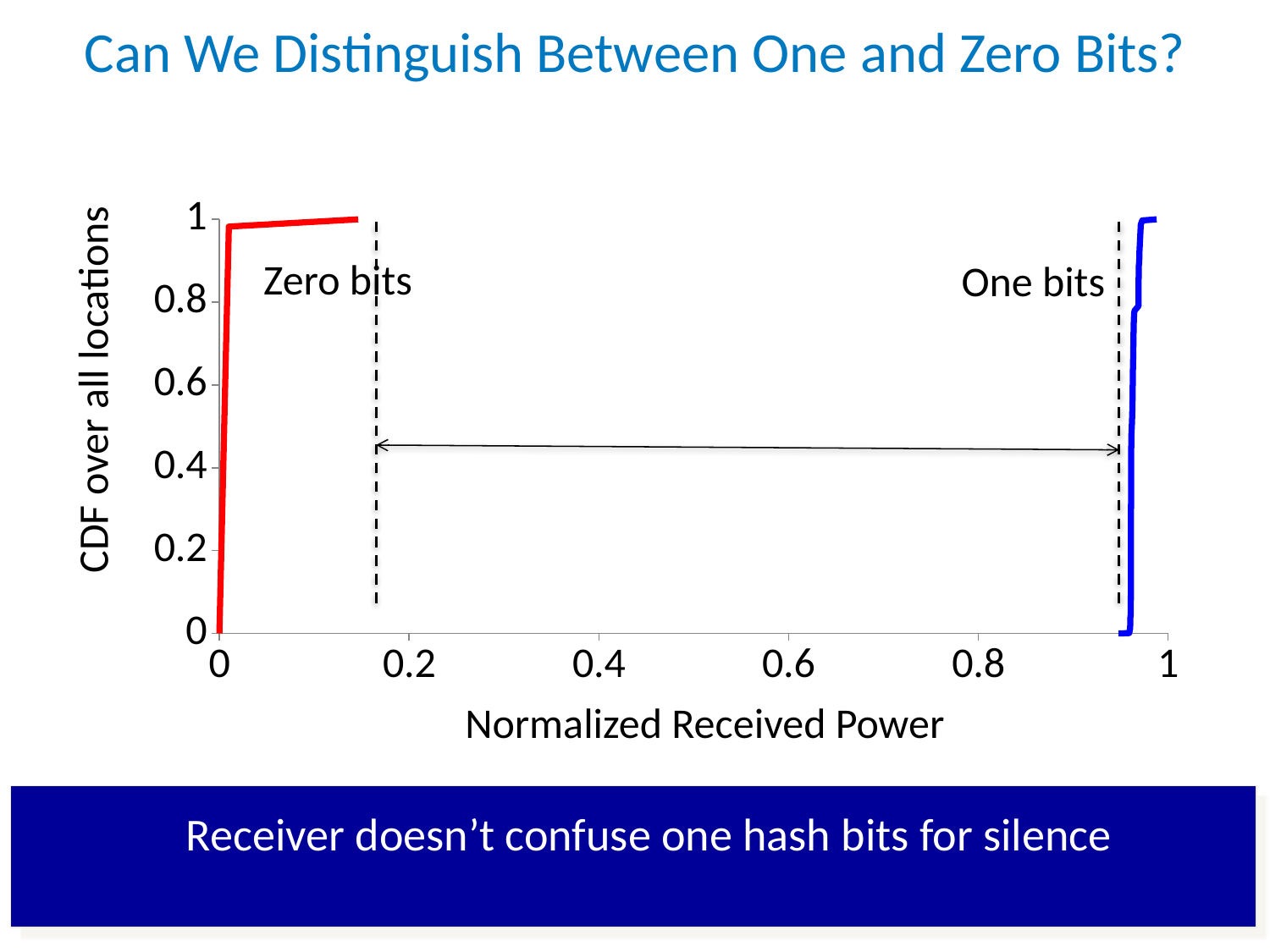
Does the CDF for the One bits curve rise or fall as normalized received power increases? rise Is the normalized received power of the Zero bits curve greater or less than 0.2? less What kind of chart is shown on the slide? line chart Is the normalized received power of the One bits curve greater or less than 0.8? greater How many curves are plotted on the chart? 2 What is the highest tick value shown on the x axis? 1 What is the maximum value shown on the y axis? 1 What is the label of the y axis? CDF over all locations Which curve lies at higher normalized received power, Zero bits or One bits? One bits What is the label of the x axis? Normalized Received Power Which curve lies at lower normalized received power, Zero bits or One bits? Zero bits